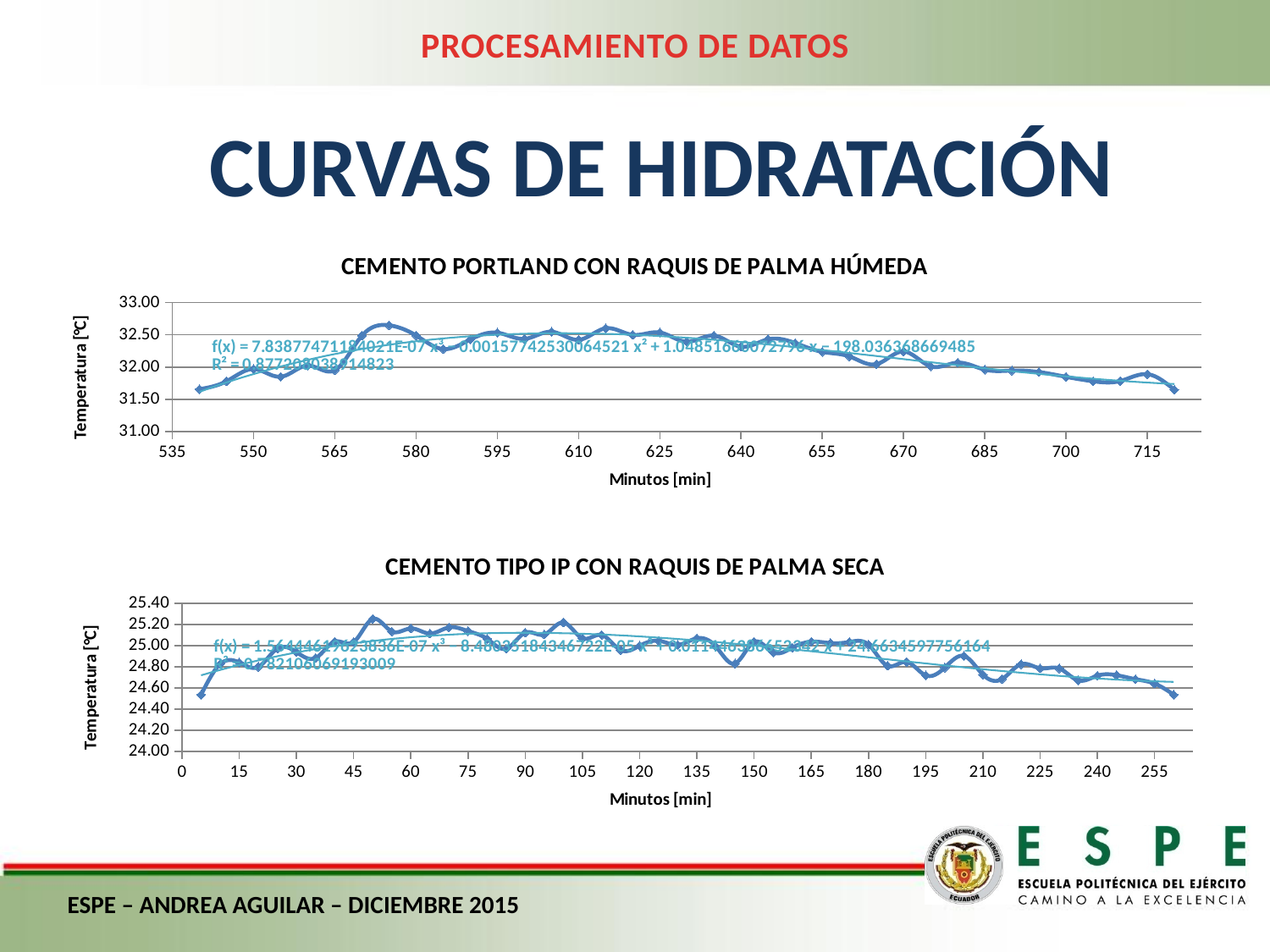
In the top chart (CEMENTO PORTLAND CON RAQUIS DE PALMA HÚMEDA), do the temperature values rise or fall between 640 and 715 minutes? fall In the top chart (CEMENTO PORTLAND CON RAQUIS DE PALMA HÚMEDA), is the temperature at the last plotted point (around 720 minutes) greater or less than 32.00? less In the top chart (CEMENTO PORTLAND CON RAQUIS DE PALMA HÚMEDA), is the temperature at the first plotted point (around 540 minutes) greater or less than 32.00? less In the bottom chart (CEMENTO TIPO IP CON RAQUIS DE PALMA SECA), is the temperature at the first plotted point (around 5 minutes) greater or less than 24.80? less In the bottom chart (CEMENTO TIPO IP CON RAQUIS DE PALMA SECA), what is the label of the y axis? Temperatura [ºC] In the top chart (CEMENTO PORTLAND CON RAQUIS DE PALMA HÚMEDA), what is the label of the x axis? Minutos [min] What kind of chart is the top chart titled "CEMENTO PORTLAND CON RAQUIS DE PALMA HÚMEDA"? Line chart What kind of chart is the bottom chart titled "CEMENTO TIPO IP CON RAQUIS DE PALMA SECA"? Line chart In the bottom chart (CEMENTO TIPO IP CON RAQUIS DE PALMA SECA), do the temperature values rise or fall between 180 and 255 minutes? fall How many charts are shown on the slide? 2